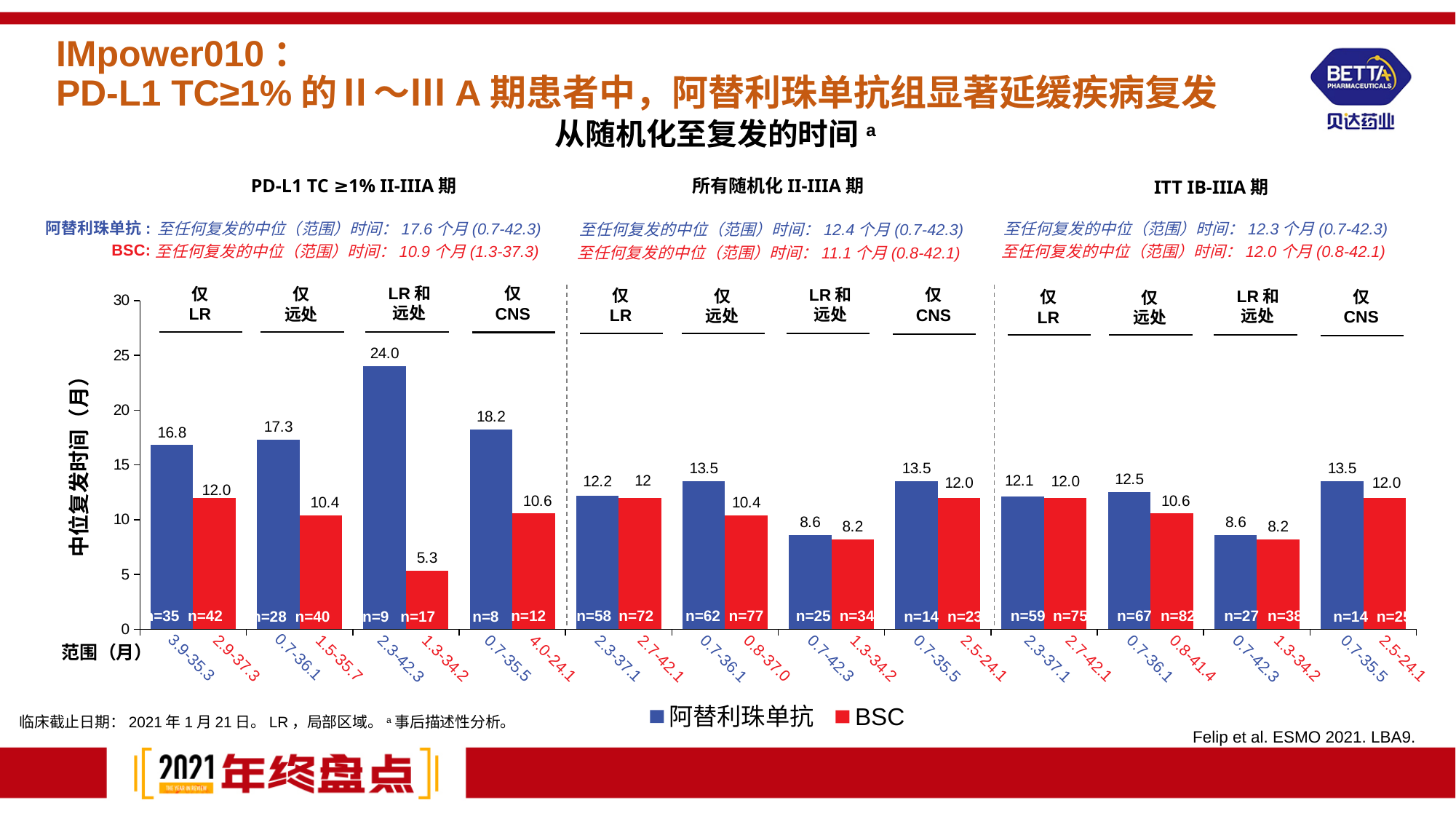
How many series does the legend list? 2 In the PD-L1 TC ≥1% II-IIIA panel, what is the median time to relapse for BSC in the LR 和远处 group? 5.3 In the ITT IB-IIIA panel, what is the value for BSC in the 仅远处 group? 10.6 Across the whole chart, which bar has the highest median relapse time? 阿替利珠单抗, LR 和远处, PD-L1 TC ≥1% II-IIIA In the ITT IB-IIIA panel, is the 阿替利珠单抗 value for the LR 和远处 group greater or less than 10? less In the 所有随机化 II-IIIA panel, what is the value for 阿替利珠单抗 in the 仅远处 group? 13.5 In the PD-L1 TC ≥1% II-IIIA panel, what is the median time to relapse for 阿替利珠单抗 in the LR 和远处 group? 24.0 In the PD-L1 TC ≥1% II-IIIA panel, what is the difference between 阿替利珠单抗 and BSC in the 仅CNS group? 7.6 What kind of chart is shown on the slide? bar chart What colour represents BSC in the chart? red Across the whole chart, which bar has the lowest median relapse time? BSC, LR 和远处, PD-L1 TC ≥1% II-IIIA In the PD-L1 TC ≥1% II-IIIA panel, which is larger in the 仅LR group: 阿替利珠单抗 or BSC? 阿替利珠单抗